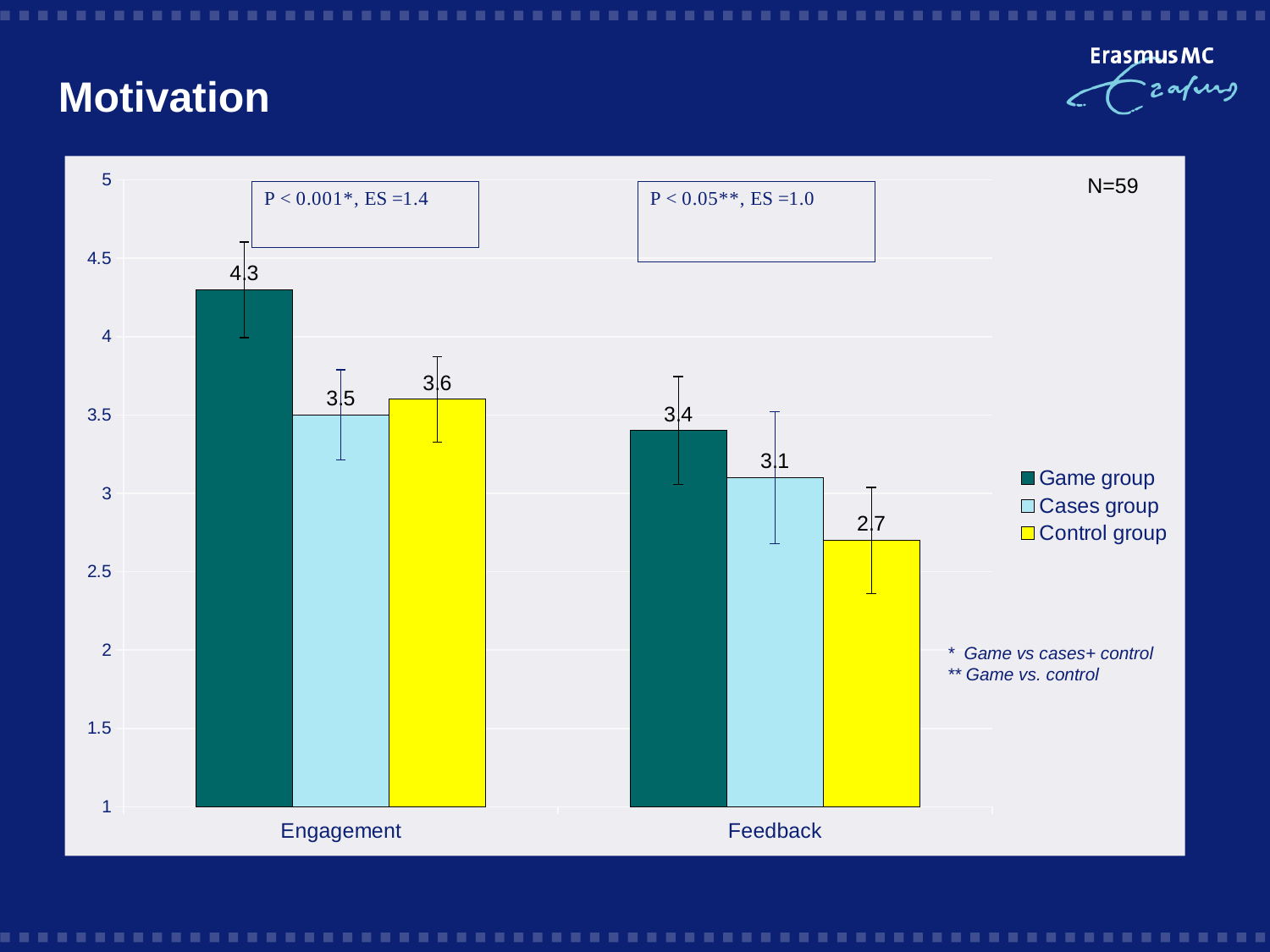
What kind of chart is shown on the slide? bar chart What is the value for the Game group in the Engagement category? 4.3 What is the value for the Cases group in the Engagement category? 3.5 How many categories are shown on the x axis? 2 Which is larger in the Engagement category: the Cases group value or the Control group value? Control group What is the value for the Control group in the Feedback category? 2.7 Is the value for the Game group in the Engagement category greater or less than 4? greater Which group has the lowest value in the Feedback category? Control group How many series does the legend list? 3 What is the difference between the Game group and the Control group values in the Feedback category? 0.7 Which group has the highest value in the Engagement category? Game group What is the sample size (N) stated on the slide? N=59